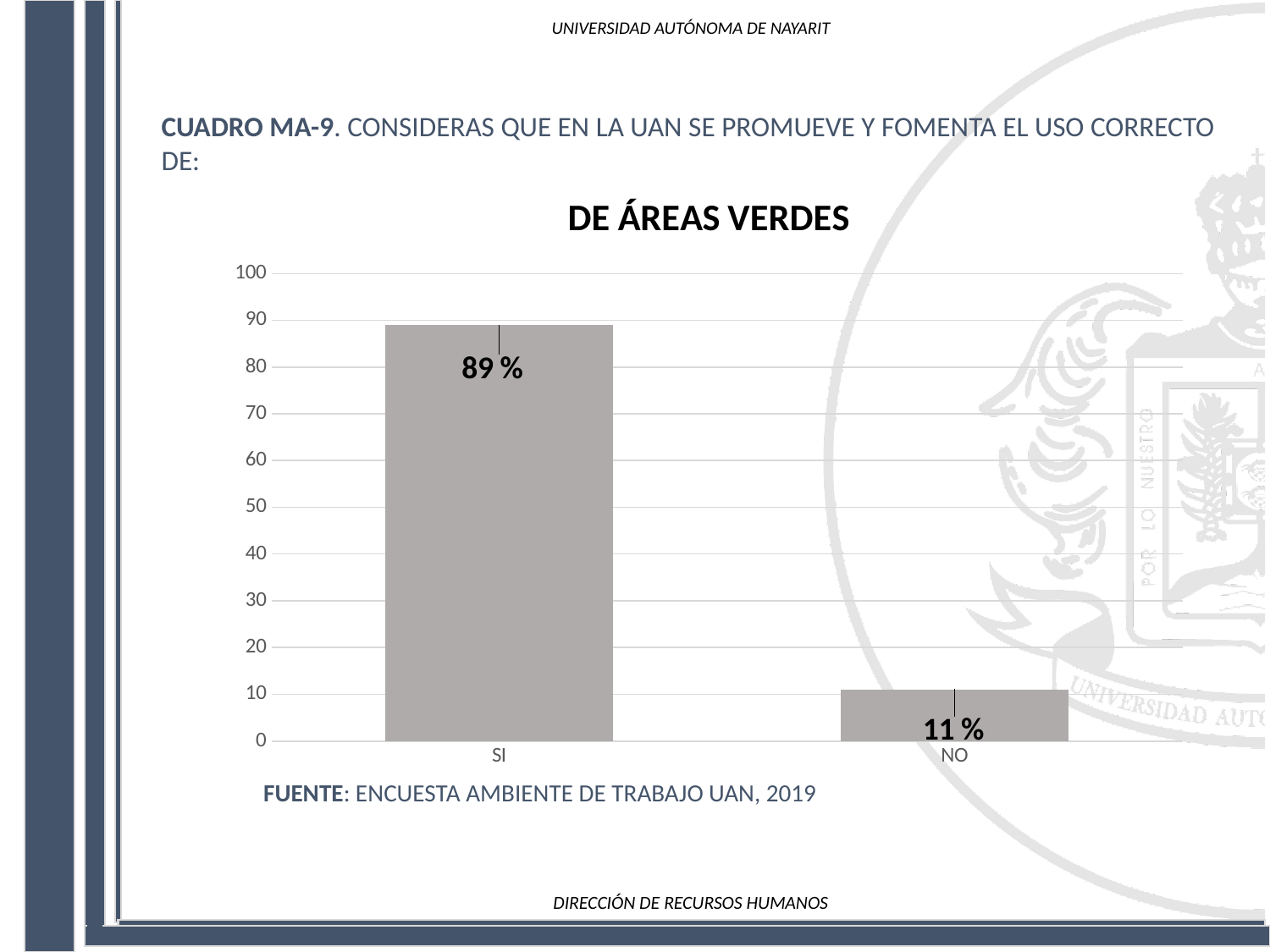
What is the value for SI? 89 % What is the difference between the values for SI and NO? 78 % Which category has the highest value? SI How many categories are shown on the x axis? 2 What kind of chart is shown? bar chart Which category has the lowest value? NO Is the value for NO greater or less than 20? less Which is larger, the value for SI or the value for NO? SI What is the source cited below the chart? ENCUESTA AMBIENTE DE TRABAJO UAN, 2019 What is the title of the chart? DE ÁREAS VERDES What is the value for NO? 11 % Is the value for SI greater or less than 80? greater